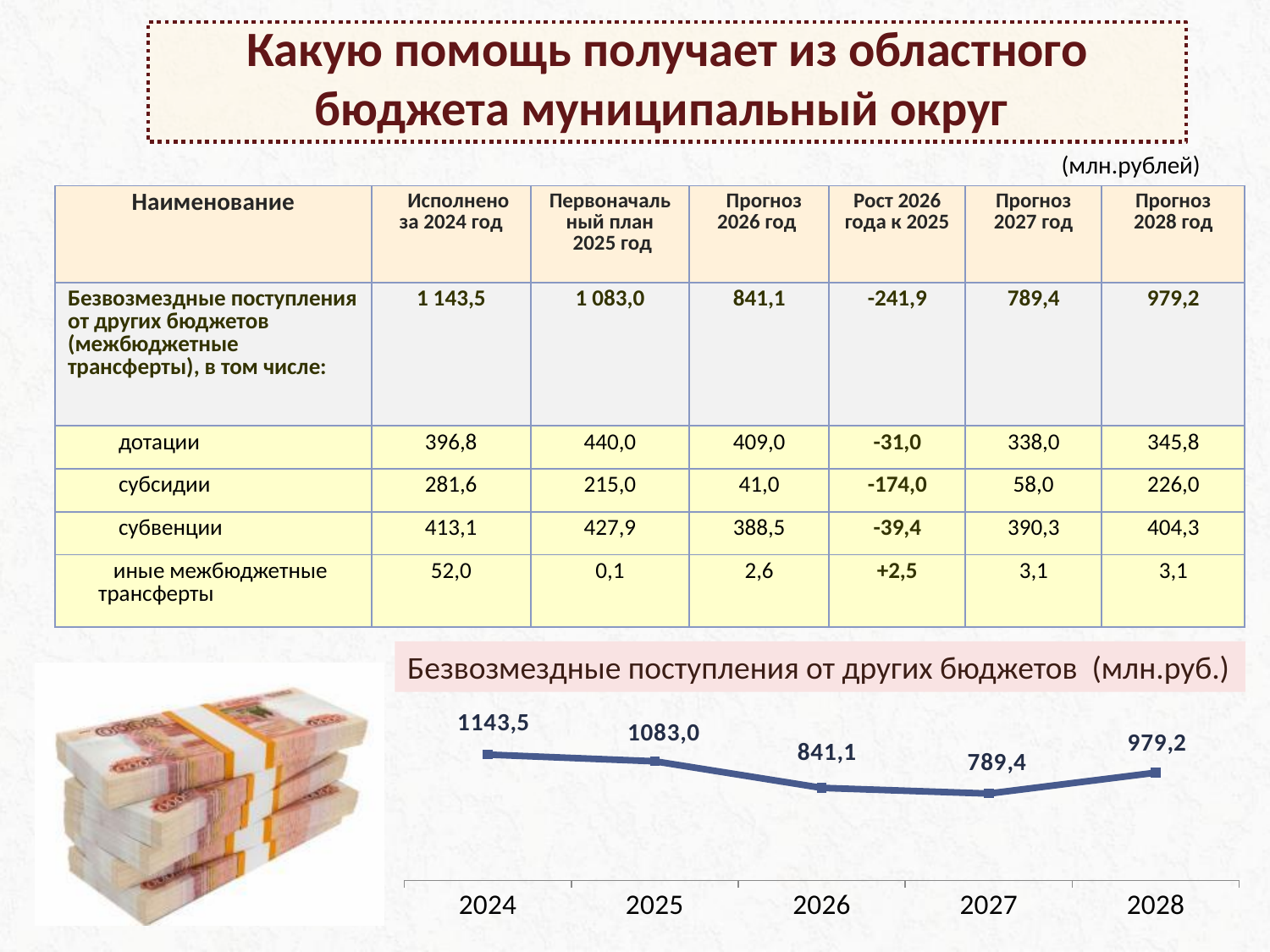
На сколько значение 2025 года на графике больше значения 2026 года? 241,9 В каком году на графике безвозмездных поступлений значение наименьшее? 2027 Как называется график в нижней части слайда? Безвозмездные поступления от других бюджетов (млн.руб.) В каком году на графике безвозмездных поступлений значение наибольшее? 2024 Как меняются значения на графике с 2024 по 2027 год? Снижаются Какое значение на графике больше: за 2025 год или за 2028 год? 2025 год Какое значение показано на графике «Безвозмездные поступления от других бюджетов» для 2024 года? 1143,5 На сколько значение 2028 года на графике больше значения 2027 года? 189,8 Какого типа диаграмма расположена в нижней части слайда? Линейный график Сколько точек (лет) показано на графике безвозмездных поступлений? 5 Какое значение показано на графике для 2028 года? 979,2 Какое значение показано на графике для 2026 года? 841,1